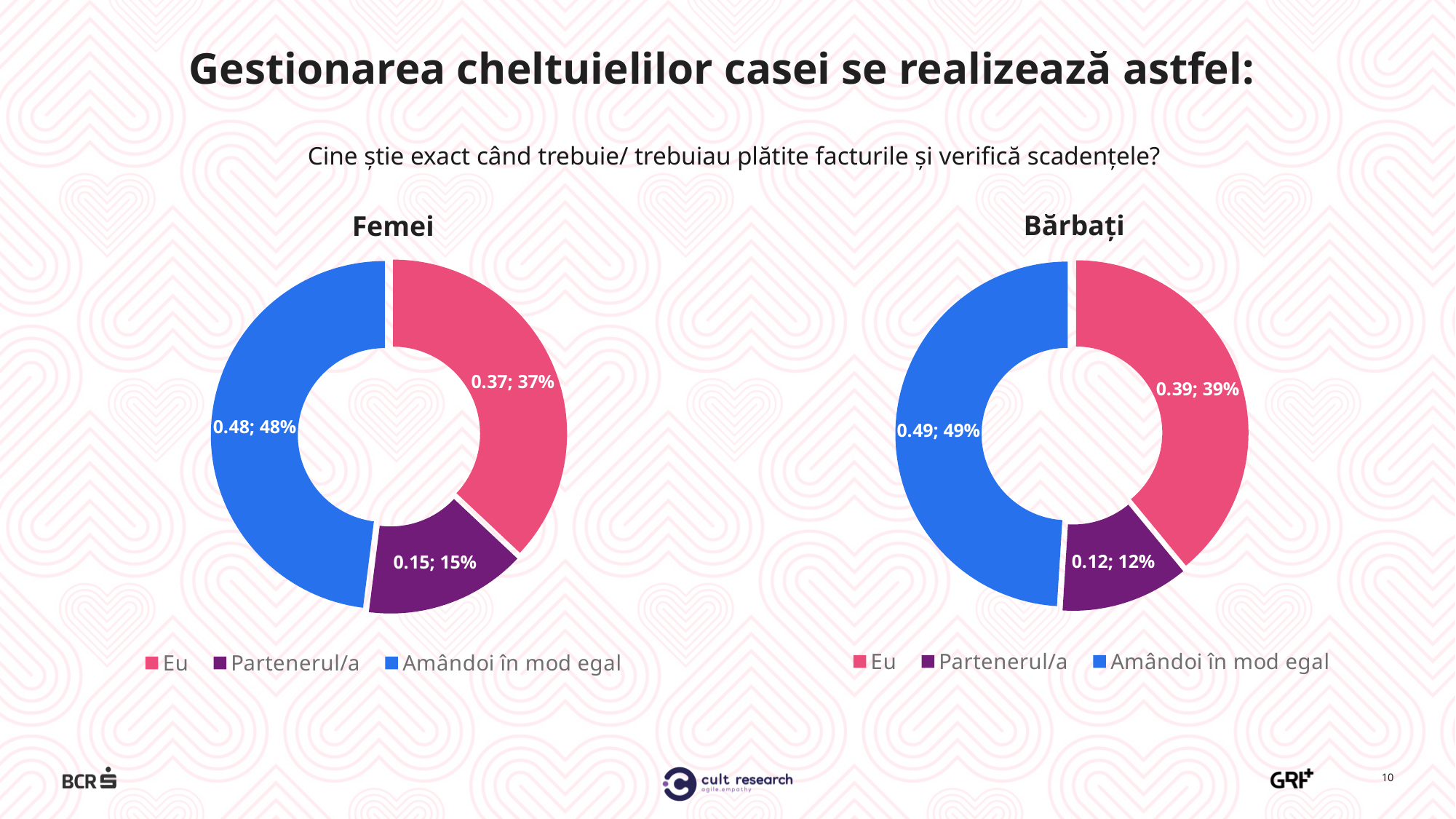
How many slices does the Femei chart have? 3 In the Bărbați chart, what is the data label shown on the Amândoi în mod egal slice? 0.49; 49% In the Femei chart, what is the difference in percentage points between Amândoi în mod egal and Eu? 11 In the Femei chart, what is the share for Amândoi în mod egal? 48% How many entries does the legend of the Bărbați chart list? 3 In the Bărbați chart, what is the difference in percentage points between Eu and Partenerul/a? 27 What type of chart is the Femei chart? Doughnut chart In the Bărbați chart, which category has the smallest share? Partenerul/a Which is larger: the Partenerul/a share in the Femei chart or the Partenerul/a share in the Bărbați chart? Femei In the Femei chart, which category has the largest share? Amândoi în mod egal In the Femei chart, what is the data label shown on the Partenerul/a slice? 0.15; 15% In the Bărbați chart, what is the share for Eu? 39%